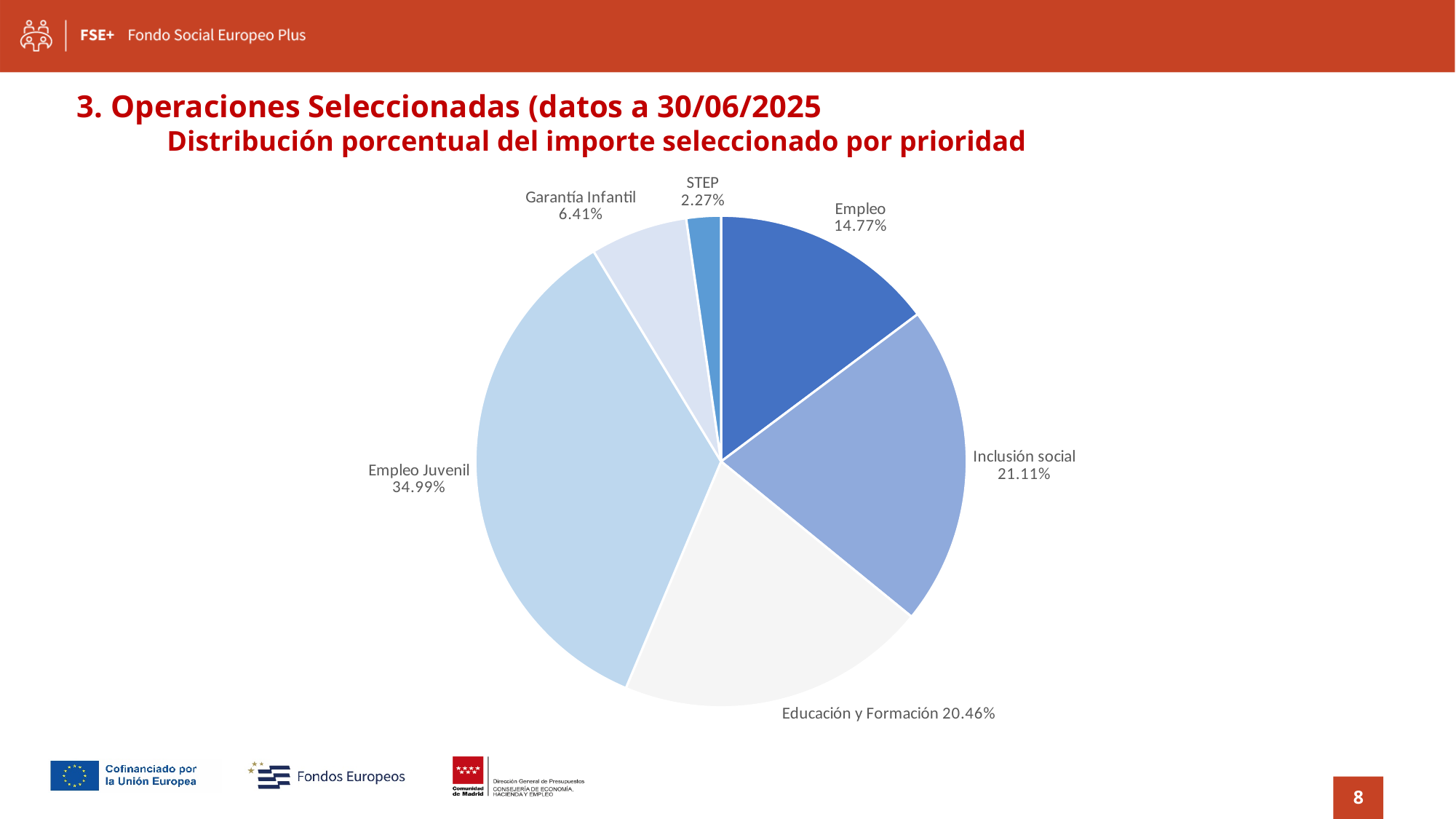
What kind of chart is shown on the slide? Pie chart What is the difference in percentage points between Empleo Juvenil and Empleo? 20.22 What percentage does the Educación y Formación slice represent? 20.46% What is the difference in percentage points between Inclusión social and Educación y Formación? 0.65 Which priority has the largest share of the selected amount? Empleo Juvenil What percentage does the Empleo Juvenil slice represent? 34.99% How many slices does the pie chart have? 6 Which priority has the smallest share of the selected amount? STEP What percentage does the STEP slice represent? 2.27% What percentage does the Inclusión social slice represent? 21.11% Which is larger, the share for Garantía Infantil or the share for Empleo? Empleo What is the title of the chart? Distribución porcentual del importe seleccionado por prioridad